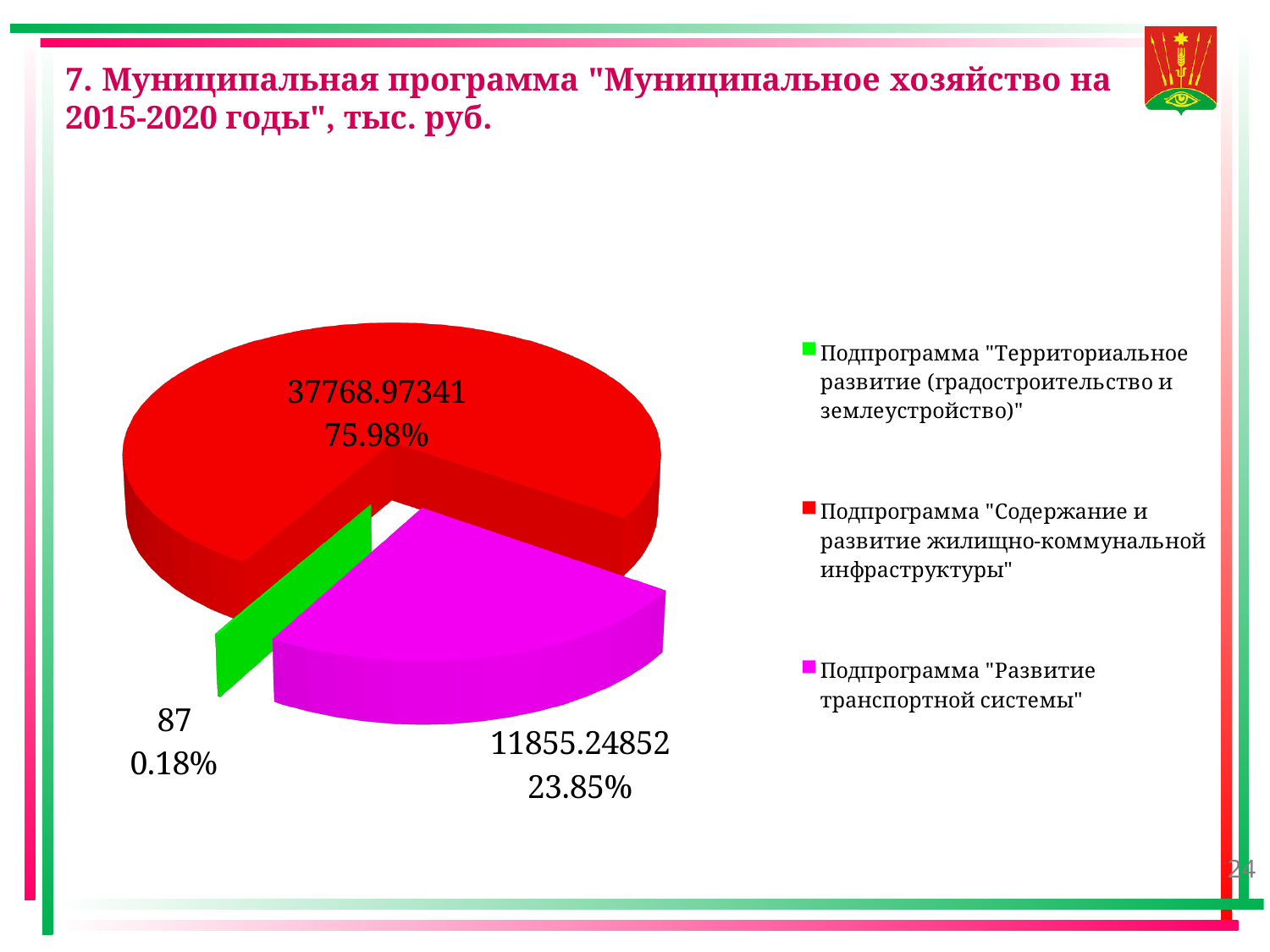
Which subprogram has the largest slice of the pie? Подпрограмма "Содержание и развитие жилищно-коммунальной инфраструктуры" Which subprogram has the smallest slice of the pie? Подпрограмма "Территориальное развитие (градостроительство и землеустройство)" What is the difference between the values for "Содержание и развитие жилищно-коммунальной инфраструктуры" and "Развитие транспортной системы"? 25913.72489 What share of the pie does the subprogram "Развитие транспортной системы" take? 23.85% What kind of chart is shown on the slide? pie chart What share of the pie does the subprogram "Территориальное развитие (градостроительство и землеустройство)" take? 0.18% What is the value for the subprogram "Развитие транспортной системы"? 11855.24852 How many slices does the pie chart have? 3 What is the value for the subprogram "Содержание и развитие жилищно-коммунальной инфраструктуры"? 37768.97341 Which colour represents the subprogram "Развитие транспортной системы" in the legend? magenta What is the value for the subprogram "Территориальное развитие (градостроительство и землеустройство)"? 87 What share of the pie does the subprogram "Содержание и развитие жилищно-коммунальной инфраструктуры" take? 75.98%